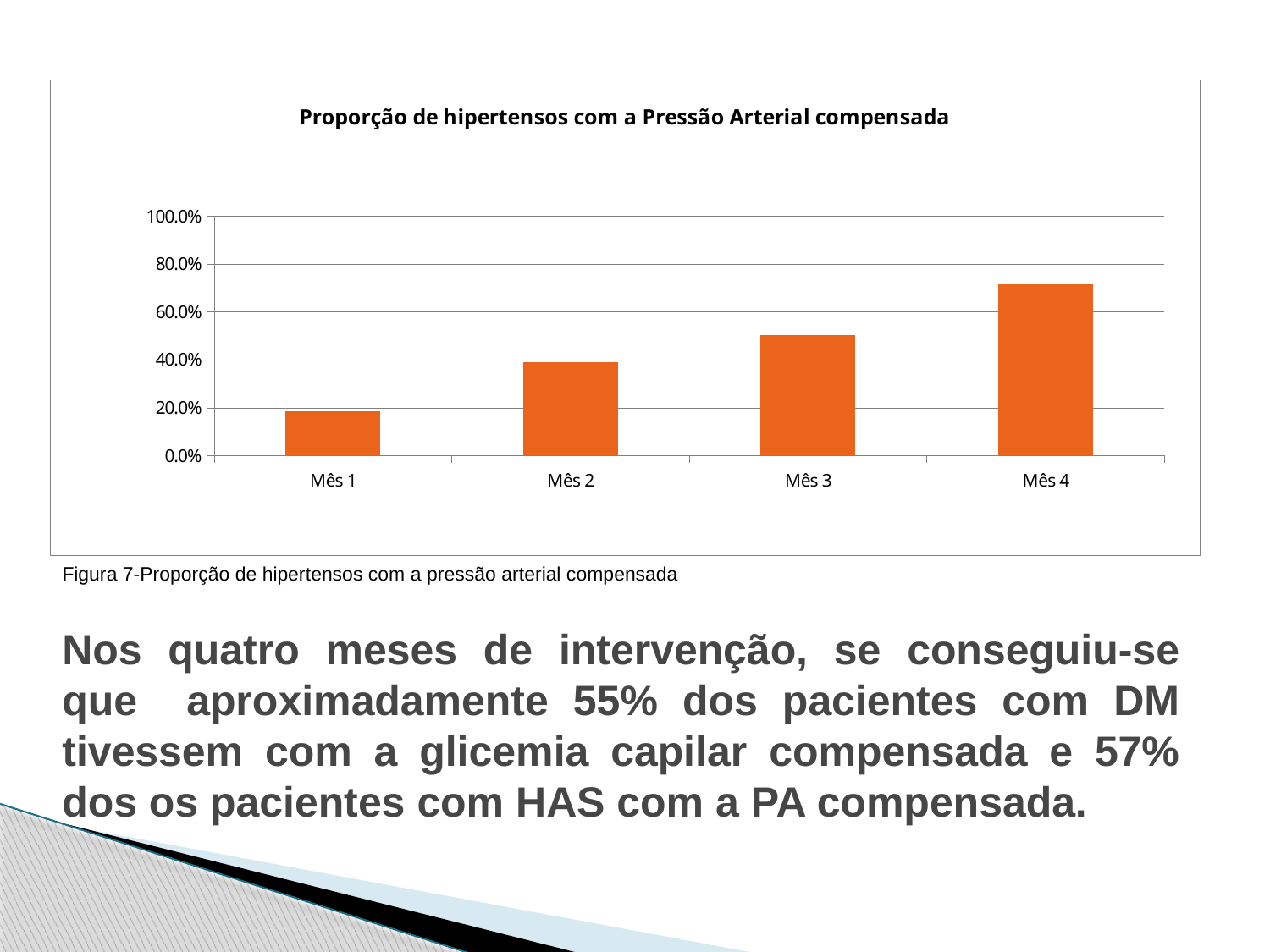
Is the value for Mês 2 greater or less than 20.0%? greater Is the value for Mês 3 greater or less than 40.0%? greater What is the title of the chart? Proporção de hipertensos com a Pressão Arterial compensada Which month has the highest proportion of hypertensive patients with compensated blood pressure? Mês 4 Is the value for Mês 4 greater or less than 80.0%? less Which month has the lowest proportion of hypertensive patients with compensated blood pressure? Mês 1 What kind of chart is shown on the slide? bar chart Do the values rise or fall from Mês 1 to Mês 4? rise How many months (categories) are plotted on the chart? 4 Which is larger, the value for Mês 3 or the value for Mês 2? Mês 3